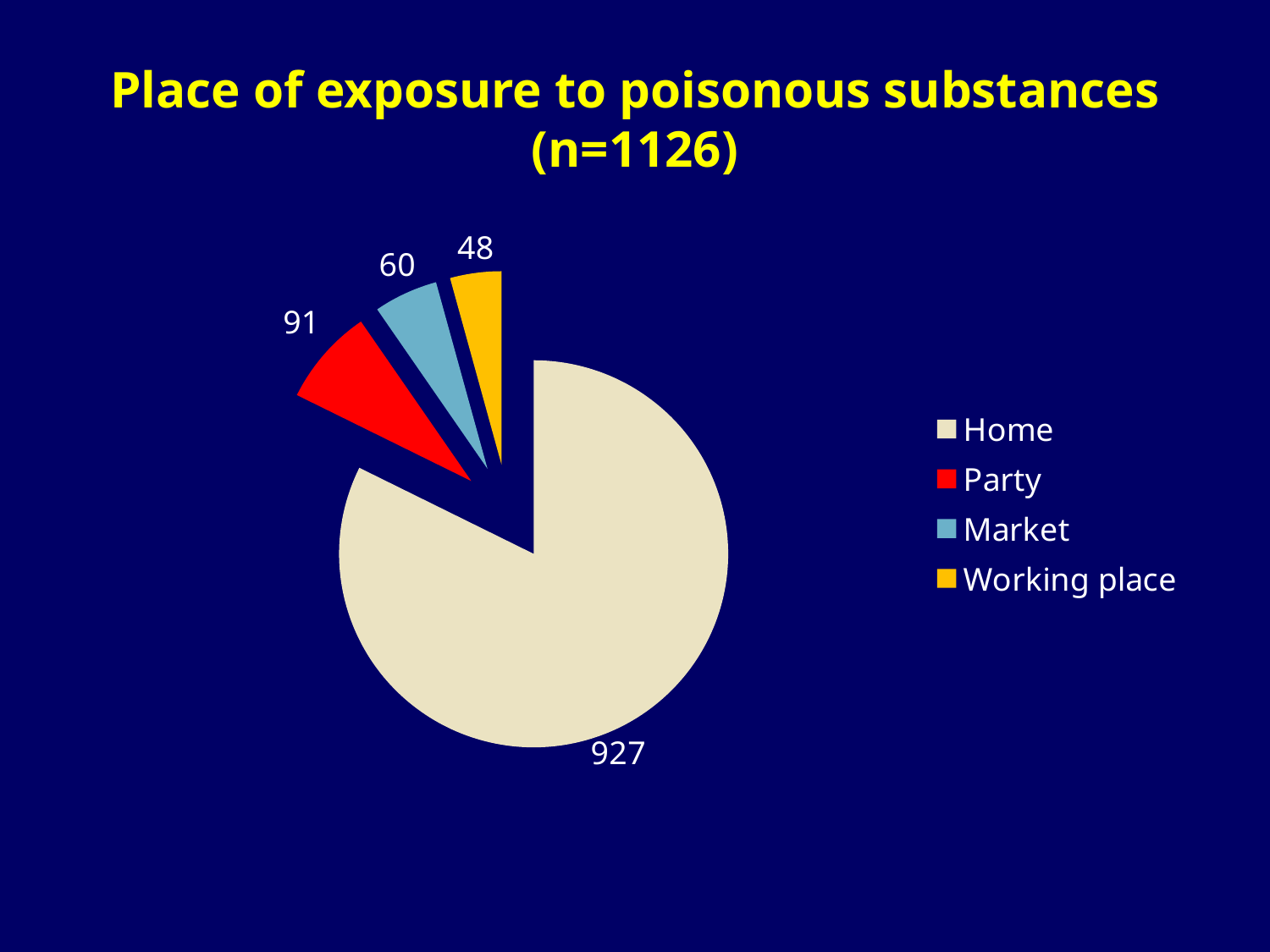
What is the value for Working place? 48 What is the value for Home? 927 What is the value for Party? 91 What is the title of the chart? Place of exposure to poisonous substances (n=1126) Which place of exposure has the highest value? Home What kind of chart is shown on the slide? pie chart What is the value for Market? 60 Which is larger, the value for Market or the value for Working place? Market Which place of exposure has the lowest value? Working place What is the difference between the values for Party and Market? 31 How many categories does the pie chart show? 4